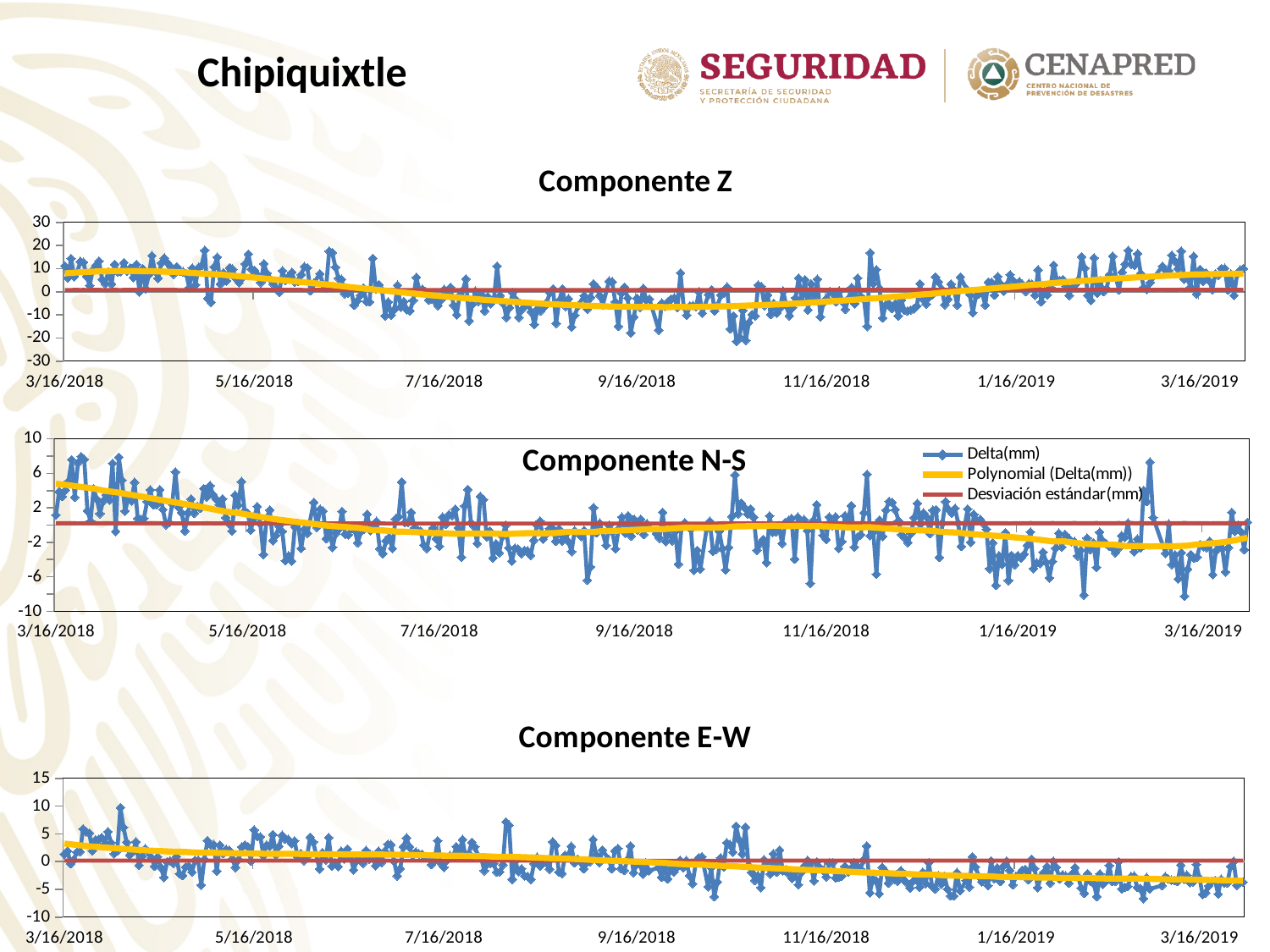
What is the title of the bottom chart on the slide? Componente E-W What kind of chart is the "Componente Z" chart? line chart In the "Componente Z" chart, is the value of the yellow polynomial line at 3/16/2018 greater or less than 0? greater What are the three series named in the legend of the "Componente N-S" chart? Delta(mm), Polynomial (Delta(mm)), Desviación estándar(mm) How many date labels are shown on the x axis of the "Componente Z" chart? 7 What is the highest value shown on the y axis of the "Componente Z" chart? 30 In the "Componente E-W" chart, is the value of the yellow polynomial line at 3/16/2019 greater or less than 0? less How many series does the legend on the "Componente N-S" chart list? 3 In the "Componente Z" chart, is the yellow polynomial line at 9/16/2018 greater or less than 0? less In the "Componente E-W" chart, does the yellow polynomial trend line rise or fall from 3/16/2018 to 3/16/2019? fall In the "Componente N-S" chart, does the yellow polynomial trend line rise or fall overall from 3/16/2018 to 3/16/2019? fall